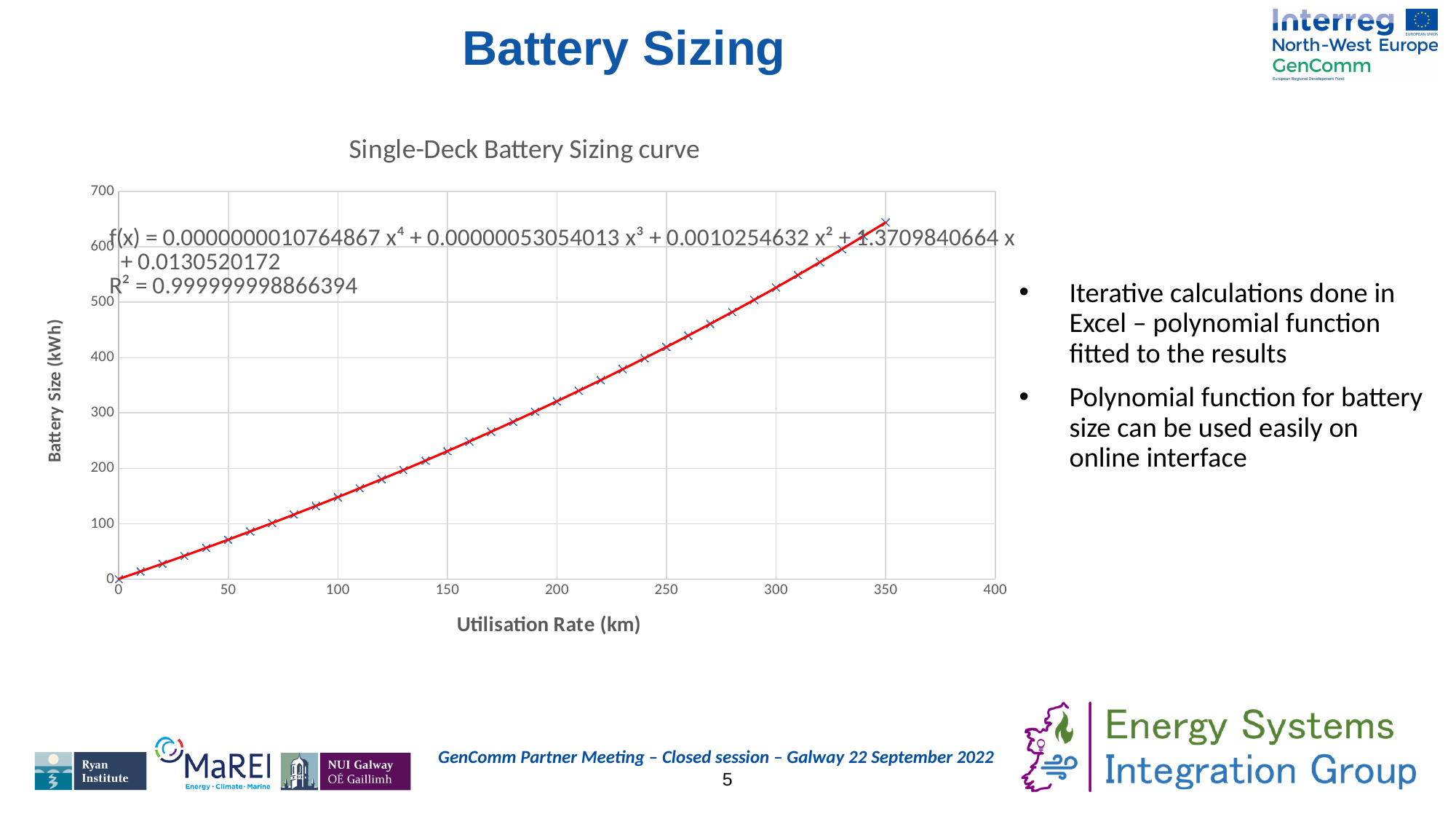
What is the label of the x axis? Utilisation Rate (km) Is the battery size at a utilisation rate of 200 km greater or less than 300 kWh? greater Is the battery size at a utilisation rate of 100 km greater or less than 200 kWh? less What kind of chart is shown on the slide? Scatter chart with a fitted trendline Do the battery size values rise or fall as the utilisation rate increases? Rise Is the battery size at a utilisation rate of 350 km greater or less than 600 kWh? greater What R² value is printed on the chart for the fitted polynomial? 0.999999998866394 At which utilisation rate is the plotted battery size lowest? 0 What is the title of the chart? Single-Deck Battery Sizing curve At which utilisation rate is the plotted battery size highest? 350